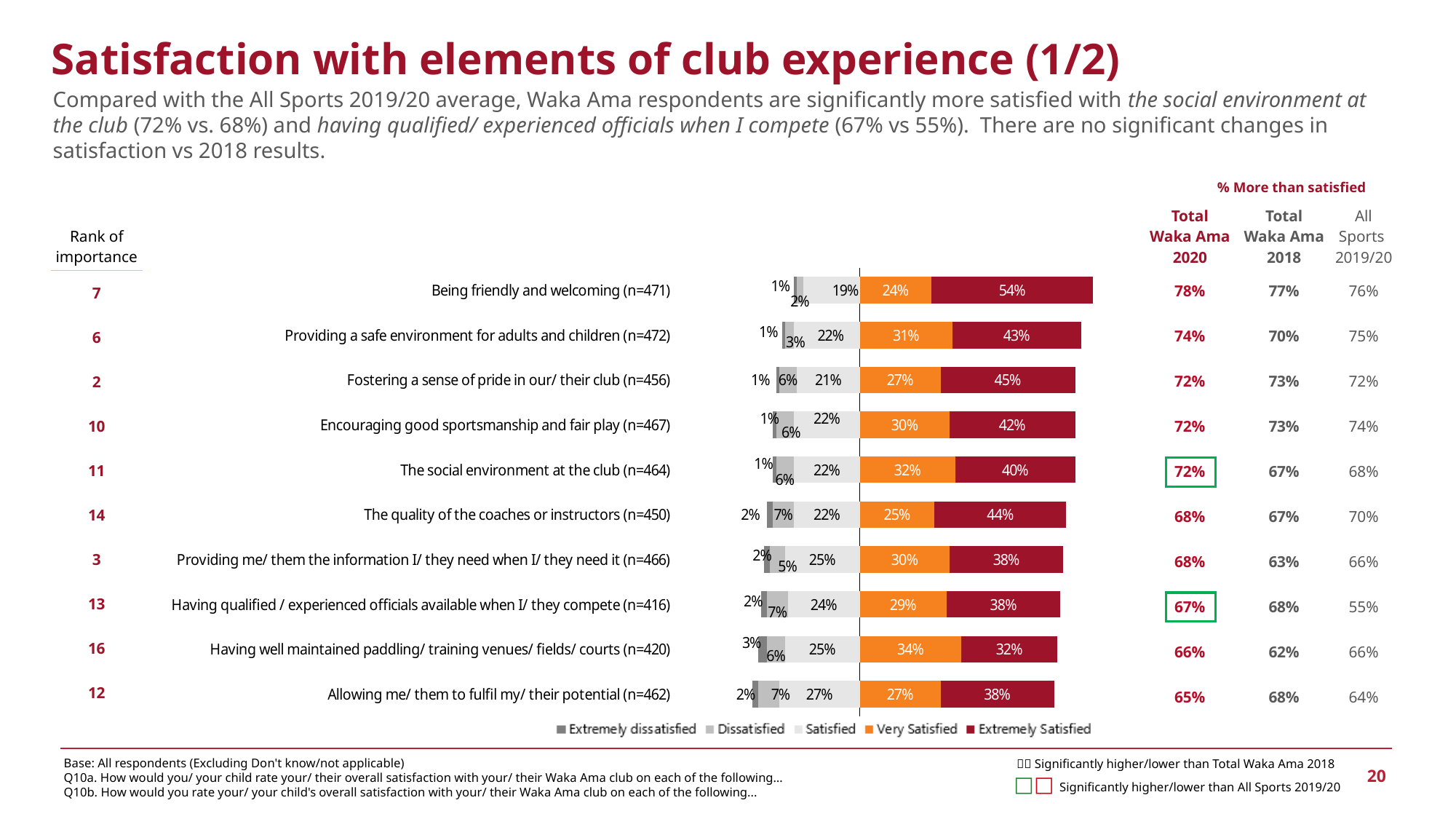
What kind of chart is shown on the slide? Stacked bar chart How many club experience elements (categories) are plotted in the chart? 10 How many series does the chart legend list? 5 For 'Being friendly and welcoming (n=471)', how much larger is the Extremely Satisfied value than the Very Satisfied value? 30 percentage points What is the Extremely Satisfied value for 'Being friendly and welcoming (n=471)'? 54% Which category has the highest Extremely Satisfied value? Being friendly and welcoming (n=471) What is the Dissatisfied value for 'The quality of the coaches or instructors (n=450)'? 7% Which category has the lowest Extremely Satisfied value? Having well maintained paddling/ training venues/ fields/ courts (n=420) What colour represents the Extremely Satisfied series in the chart? Dark red Which is larger: the Very Satisfied value for 'Having well maintained paddling/ training venues/ fields/ courts' or for 'The quality of the coaches or instructors'? Having well maintained paddling/ training venues/ fields/ courts What is the Satisfied value for 'Allowing me/ them to fulfil my/ their potential (n=462)'? 27% What is the Very Satisfied value for 'Having well maintained paddling/ training venues/ fields/ courts (n=420)'? 34%